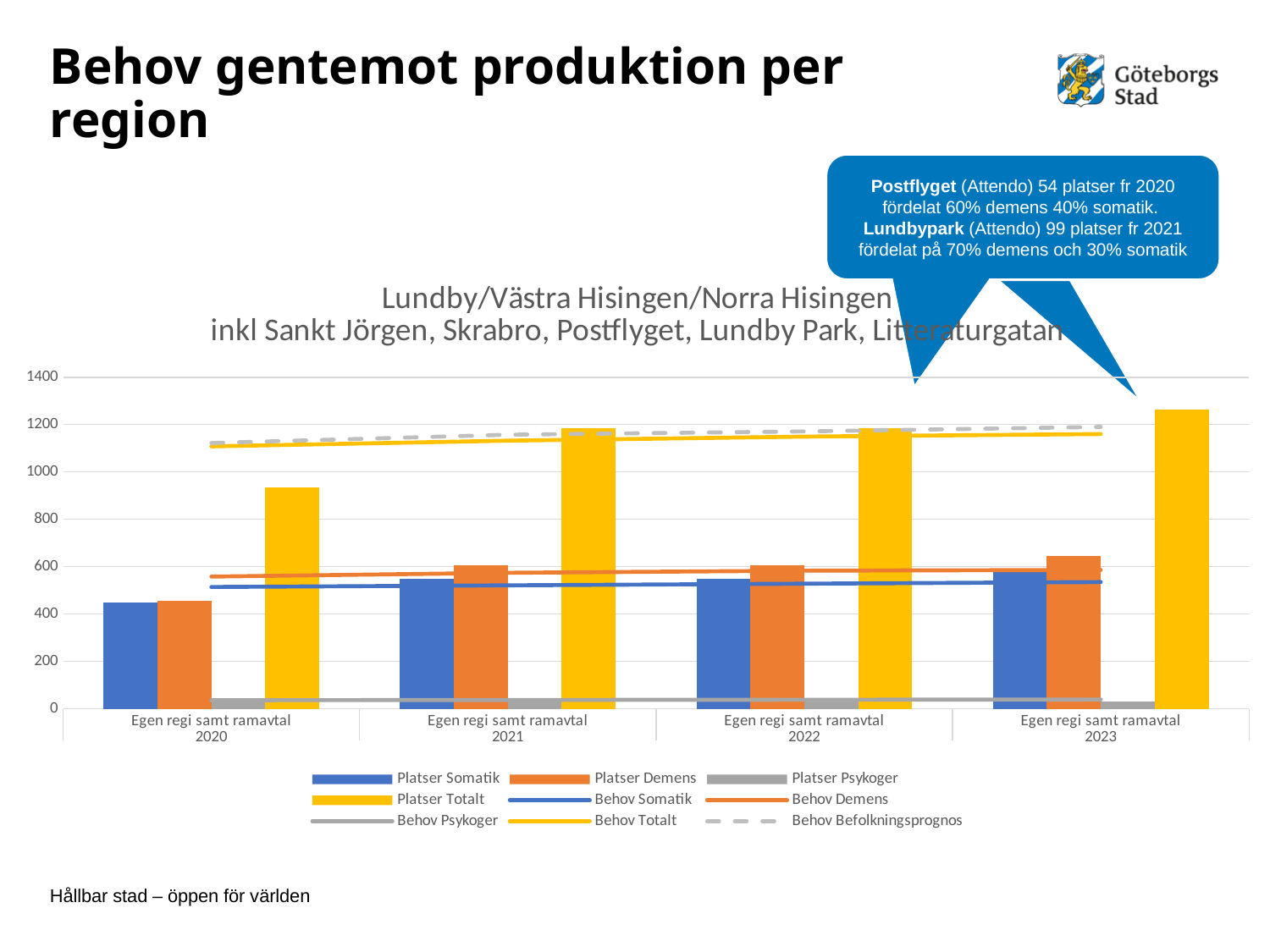
Is the Platser Totalt value for 2020 greater or less than 1000? less What is the first line of the chart title? Lundby/Västra Hisingen/Norra Hisingen Does the Platser Totalt series rise or fall from 2020 to 2023? rise In which year is the Platser Totalt bar highest? 2023 What kind of chart is shown on the slide? A bar chart combined with line series How many year categories are shown along the x axis? 4 How many series does the legend list? 9 Is the Platser Psykoger value for 2021 greater or less than 200? less In 2021, which bar is taller: Platser Demens or Platser Somatik? Platser Demens Is the Platser Somatik value for 2020 greater or less than 600? less In which year is the Platser Totalt bar lowest? 2020